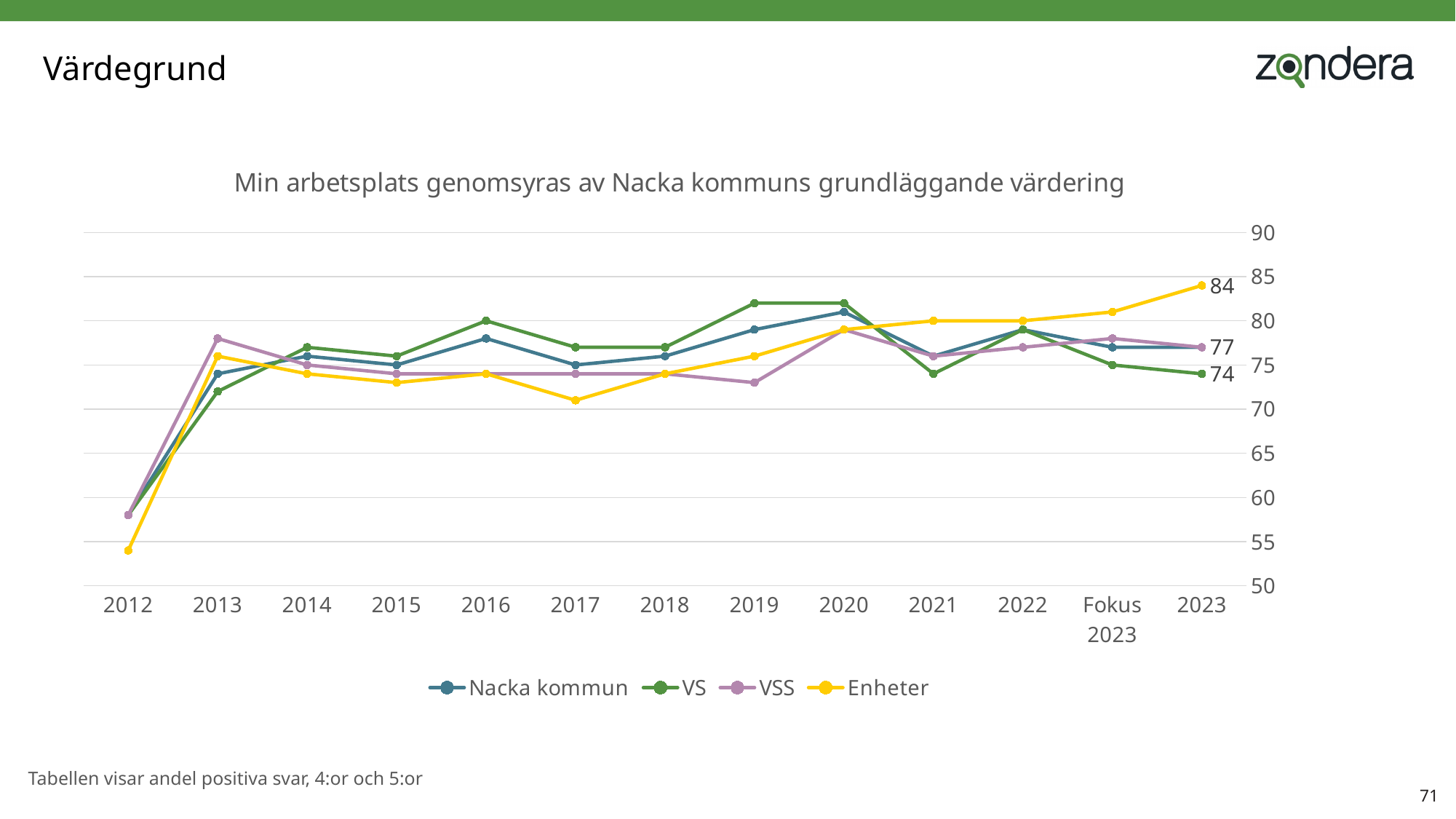
What kind of chart is shown on the slide? line chart What is the value for VS in 2023? 74 What is the difference between the Enheter and VS values in 2023? 10 How many series does the legend list? 4 What is the value for Enheter in 2023? 84 Does the Enheter series rise or fall from 2020 to 2023? rise How many categories are shown along the x axis? 13 Which series has the lowest value in 2023? VS Which series has the highest value in 2023? Enheter Is the value for Enheter in 2012 greater or less than 60? less What is the title of the chart? Min arbetsplats genomsyras av Nacka kommuns grundläggande värdering Is the value for VS in 2019 greater or less than 80? greater